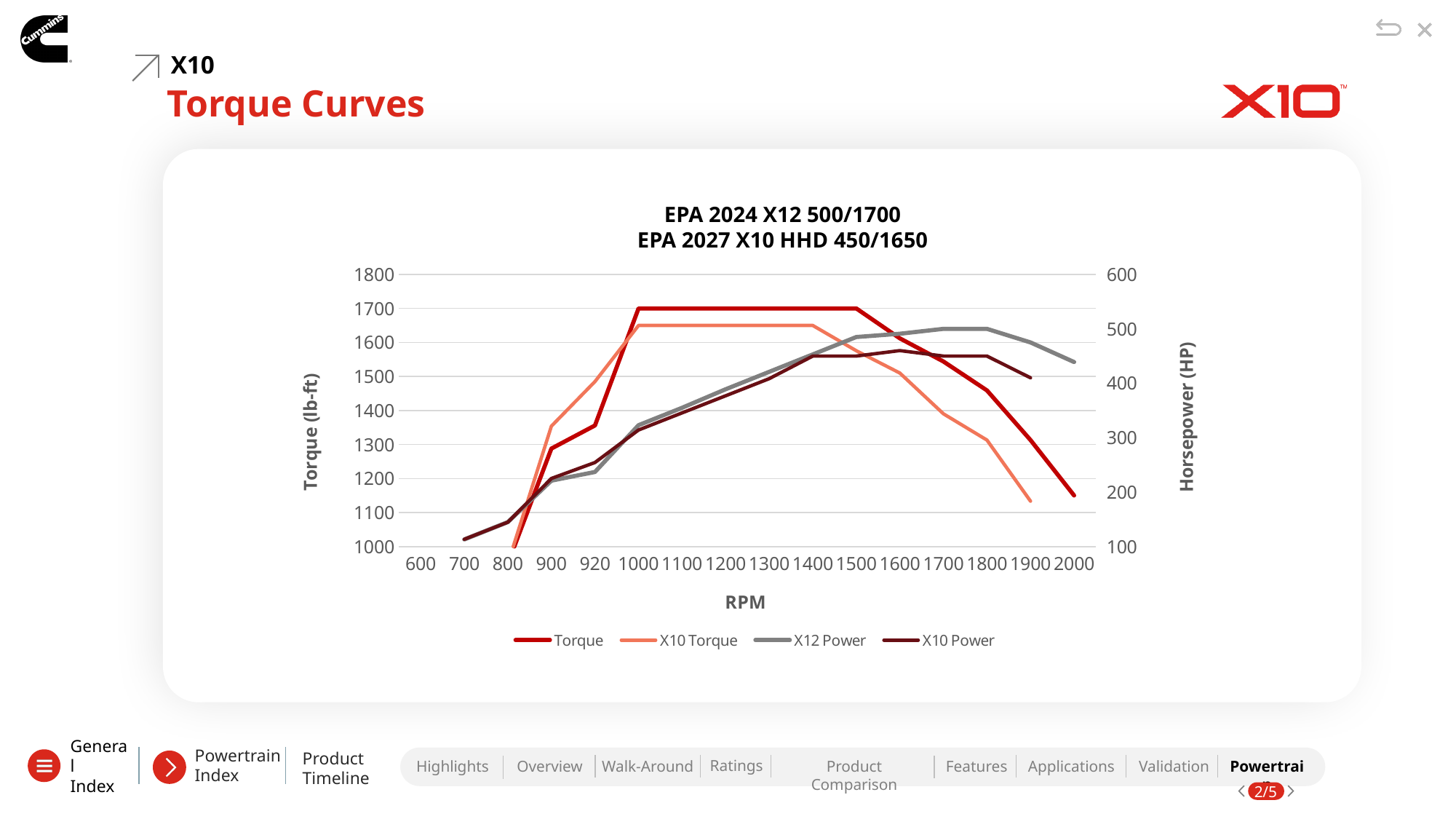
Is the X12 Power value at 2000 RPM greater or less than 400 HP? greater Does the Torque series rise or fall between 1500 RPM and 2000 RPM? fall How many series does the legend list? 4 What is the label of the left vertical axis? Torque (lb-ft) How many RPM categories are shown on the x axis? 16 Is the X10 Torque value at 900 RPM greater or less than 1300? greater What is the peak value reached by the X12 Power series on the Horsepower axis? 500 What is the peak value reached by the Torque series? 1700 What kind of chart is shown on the slide? line chart Which series reaches the highest torque value? Torque At 1800 RPM, which is higher: X12 Power or X10 Power? X12 Power Is the X10 Torque value at 1900 RPM greater or less than 1200? less